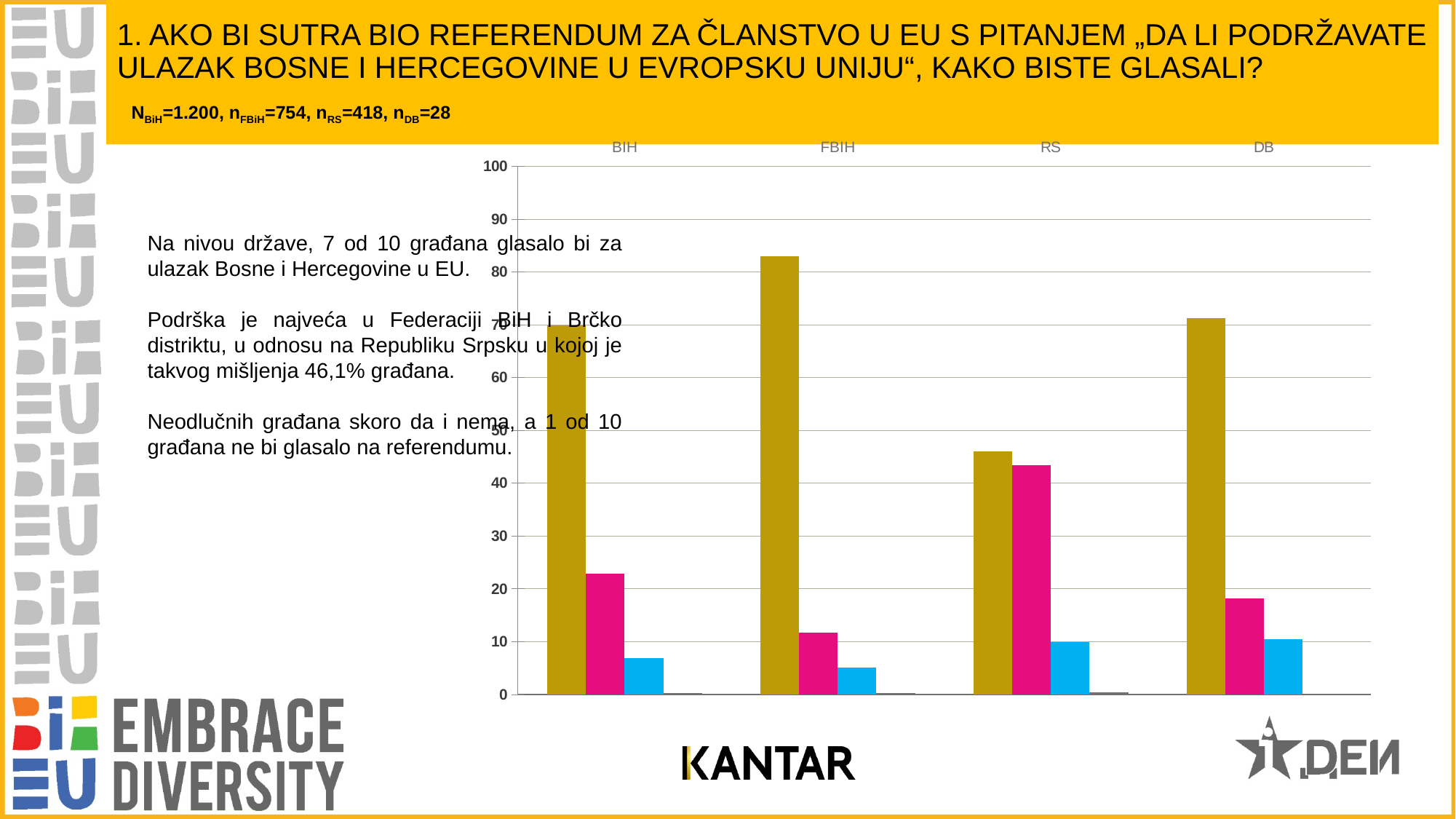
What kind of chart is shown on the slide? bar chart Is the gold bar for RS greater or less than 50? less Is the magenta bar for RS greater or less than 40? greater Which category has the tallest gold bar? FBIH Is the gold bar for BIH taller than the gold bar for RS? yes What is the highest value shown on the vertical axis of the chart? 100 Is the gold bar for BIH greater or less than 60? greater Is the magenta bar for FBIH taller or shorter than the magenta bar for BIH? shorter Which category has the shortest gold bar? RS Which category has the tallest magenta bar? RS How many categories are shown along the x axis of the chart? 4